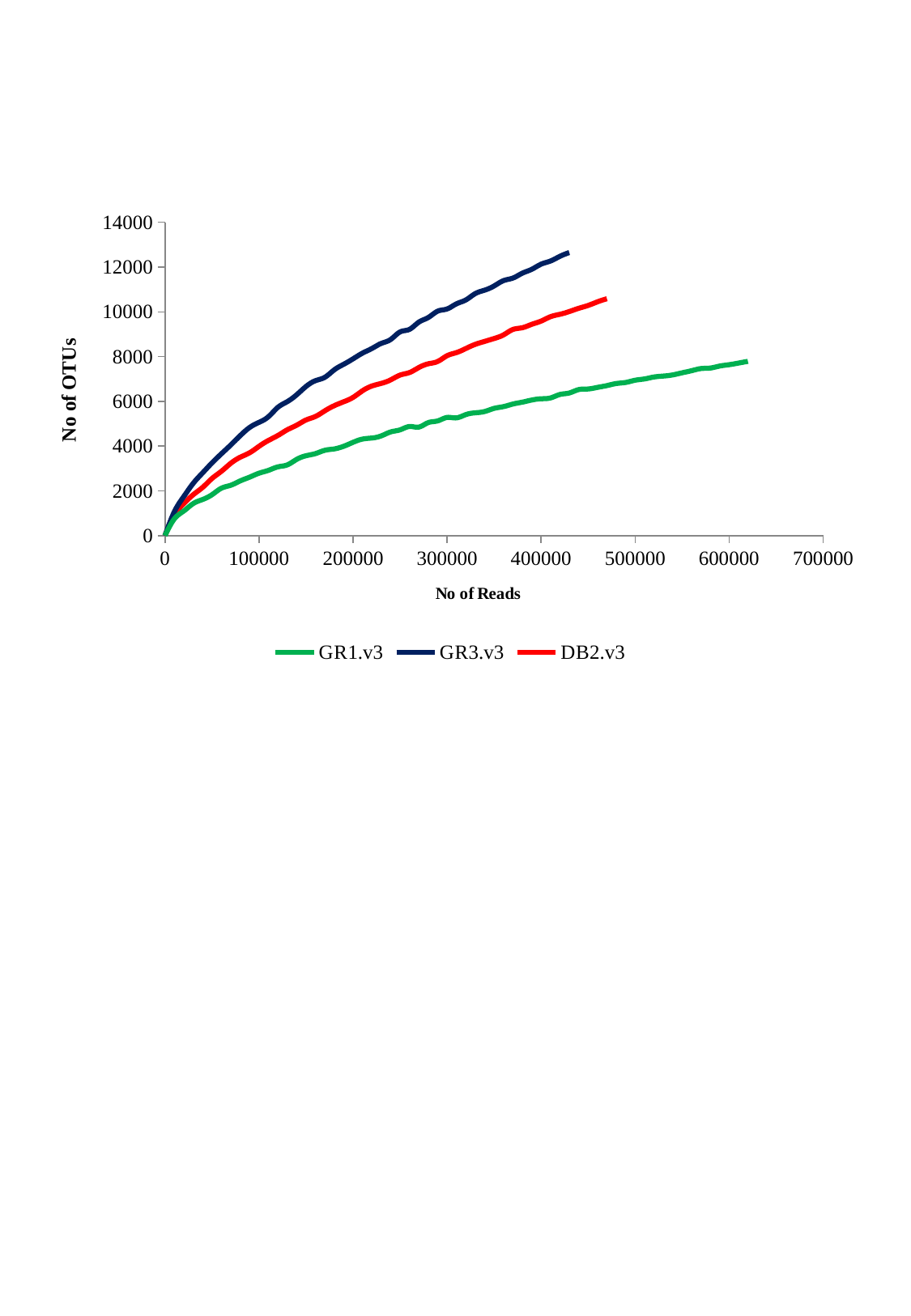
Which series reaches the highest number of OTUs? GR3.v3 What kind of chart is shown on the slide? line chart At 300000 reads, which series has more OTUs, GR3.v3 or DB2.v3? GR3.v3 Is the number of OTUs for GR1.v3 at 300000 reads greater or less than 4000? greater What colour is the line for DB2.v3? red Which series has the lowest number of OTUs at 300000 reads? GR1.v3 Is the number of OTUs for GR3.v3 at 200000 reads greater or less than 6000? greater Does the number of OTUs for GR1.v3 rise or fall as the number of reads increases? rise Is the number of OTUs for DB2.v3 at 400000 reads greater or less than 8000? greater What is the title of the x axis? No of Reads How many series does the legend list? 3 Which series extends to the largest number of reads on the x axis? GR1.v3